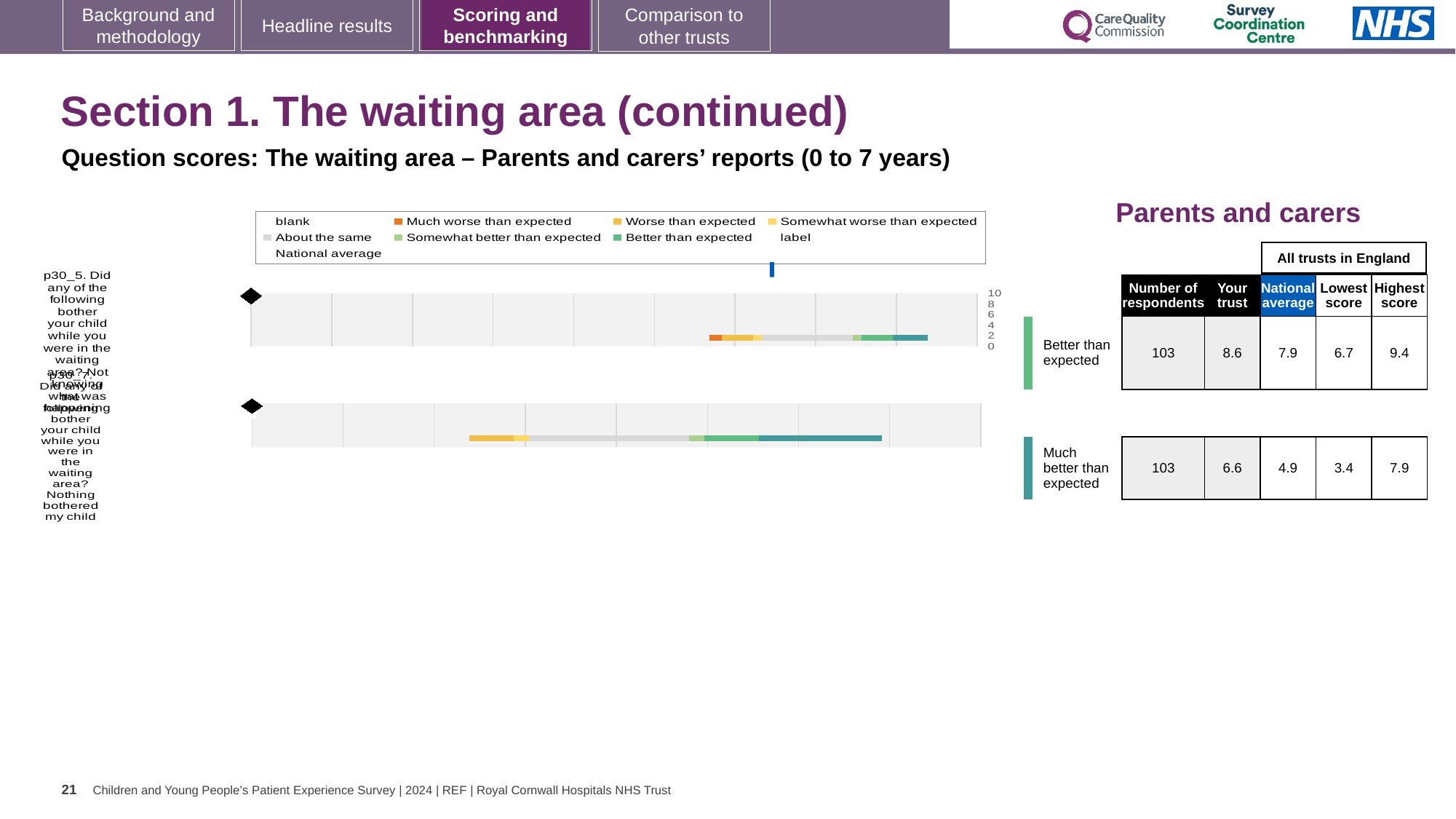
Which is larger for the question rated 'Better than expected': the trust's score or the national average? the trust's score How many question bars are plotted in the chart? 2 What is the highest score across all trusts in England for the question rated 'Better than expected'? 9.4 What is the lowest score across all trusts in England for the question rated 'Much better than expected'? 3.4 In the table, what is the 'Your trust' score for the question rated 'Better than expected'? 8.6 What kind of chart is shown on the slide? bar chart What is the national average for the question rated 'Much better than expected'? 4.9 By how much does the trust's score exceed the national average for the question rated 'Much better than expected'? 1.7 How many respondents answered the question rated 'Much better than expected'? 103 In the table, what is the 'Your trust' score for the question rated 'Much better than expected'? 6.6 What is the national average for the question rated 'Better than expected'? 7.9 What is the title of the table to the right of the chart? Parents and carers